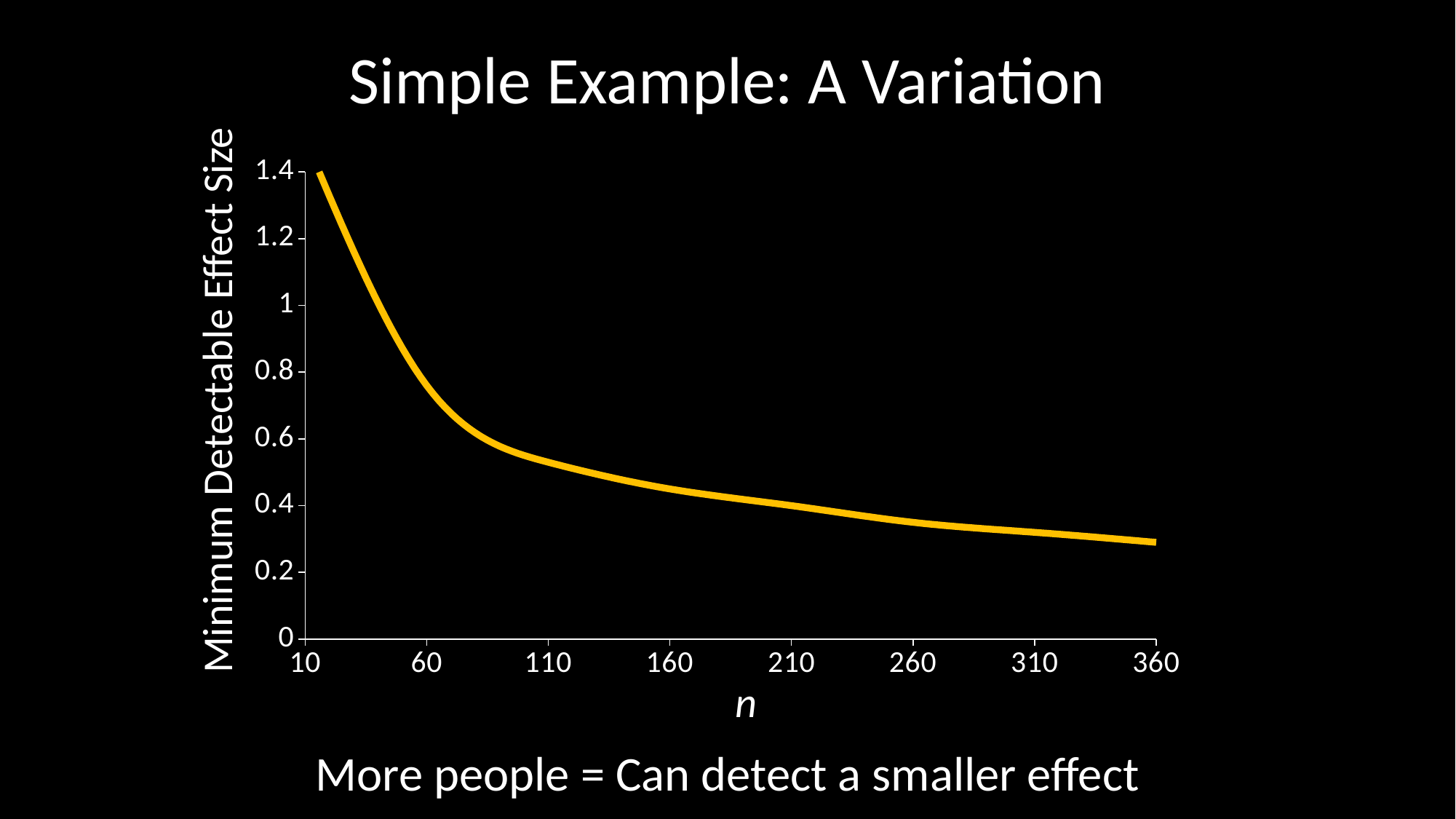
Is the Minimum Detectable Effect Size at n = 110 greater or less than 0.6? less Is the Minimum Detectable Effect Size at n = 110 greater or less than 0.4? greater Is the Minimum Detectable Effect Size at n = 10 greater or less than 1.2? greater At which value of n on the x axis is the Minimum Detectable Effect Size highest? 10 What is the label of the y axis? Minimum Detectable Effect Size As n increases along the x axis, does the Minimum Detectable Effect Size rise or fall? fall Which is larger: the Minimum Detectable Effect Size at n = 60 or at n = 160? n = 60 What kind of chart is shown on the slide? line chart At which value of n on the x axis is the Minimum Detectable Effect Size lowest? 360